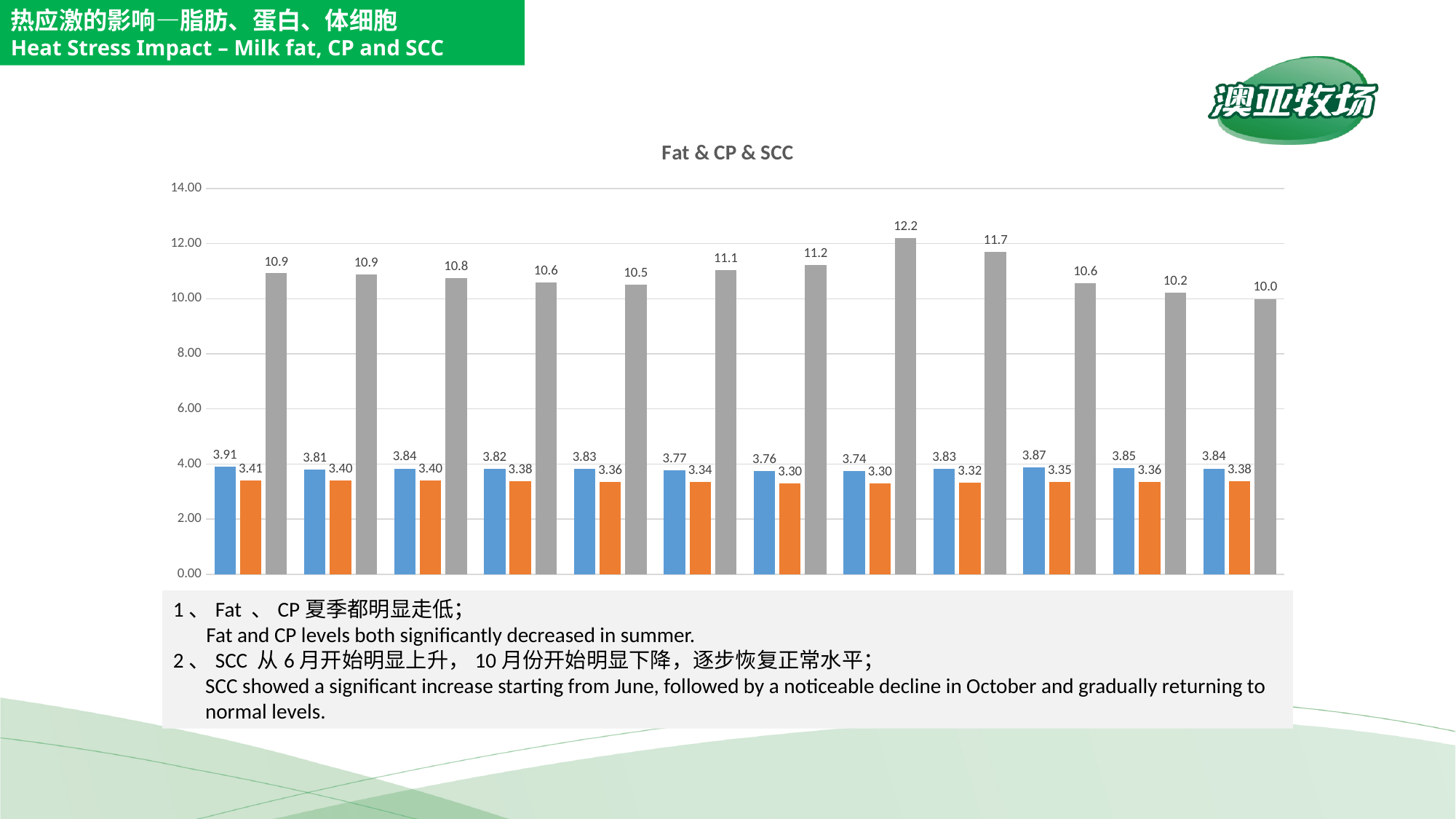
In the first group, which is larger, the blue bar or the orange bar? the blue bar How many groups of bars are plotted along the x axis? 12 Is the value of the gray bar in the twelfth group greater or less than 8.00? greater What is the difference between the highest and lowest gray bar values? 2.2 Which group has the highest blue bar value? the first group (3.91) What is the value of the orange bar in the eighth group? 3.30 What is the value of the tallest gray bar? 12.2 How many bars are there in each group? 3 What is the title of the chart? Fat & CP & SCC What is the value of the blue bar in the first group? 3.91 What is the value of the shortest gray bar? 10.0 What kind of chart is shown on the slide? bar chart